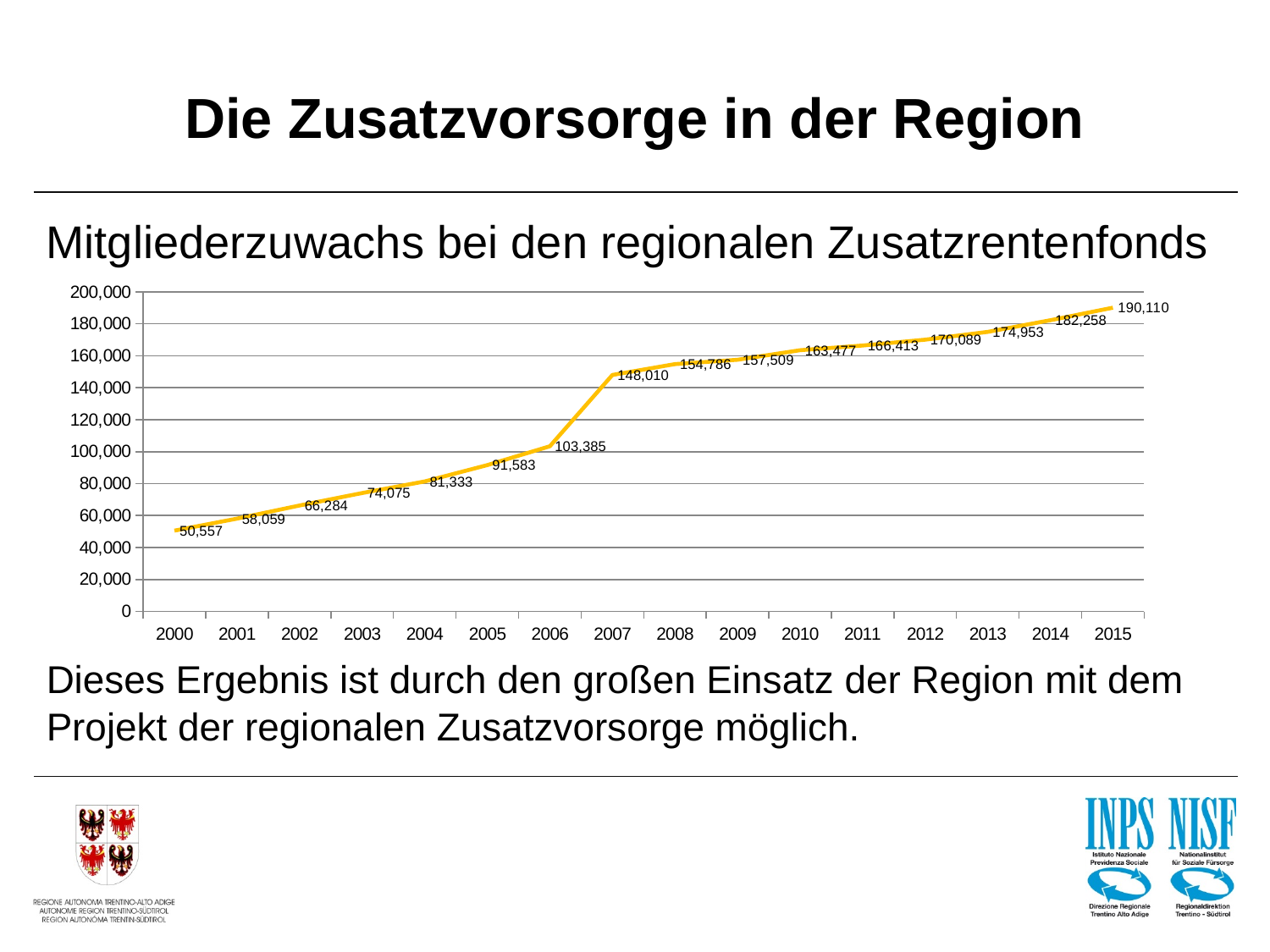
Which year has the highest value? 2015 Is the value for 2004 greater or less than 100,000? less What is the value for 2011? 166,413 What is the value for 2000? 50,557 What is the value for 2015? 190,110 What is the value for 2007? 148,010 What is the difference between the values for 2015 and 2000? 139,553 Which year has the lowest value? 2000 What kind of chart is shown? line chart What is the difference between the values for 2007 and 2006? 44,625 Which is larger, the value for 2005 or the value for 2009? 2009 How many years are plotted on the chart? 16